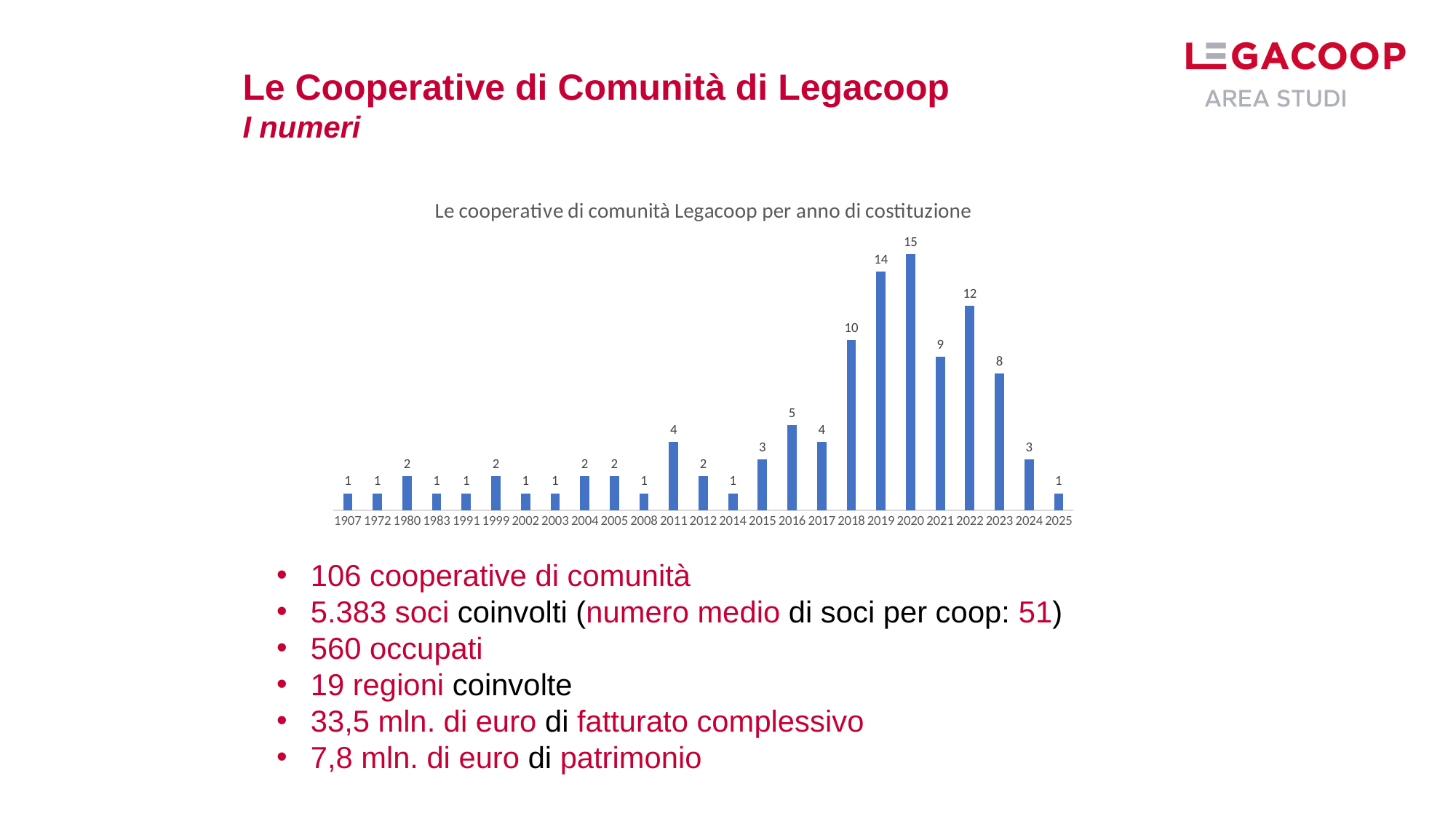
What is the value shown for 2018? 10 What is the title of the chart? Le cooperative di comunità Legacoop per anno di costituzione What is the value shown for 2011? 4 Which year has the highest number of cooperatives founded? 2020 How many years (categories) are shown on the x axis? 25 Which year has the larger value, 2022 or 2023? 2022 Do the values generally rise or fall from 2020 to 2025? fall What is the difference between the values for 2016 and 2024? 2 How many cooperatives were founded in 2020 according to the chart? 15 What is the difference between the values for 2019 and 2021? 5 What type of chart is shown on the slide? bar chart What is the lowest value shown on the chart? 1